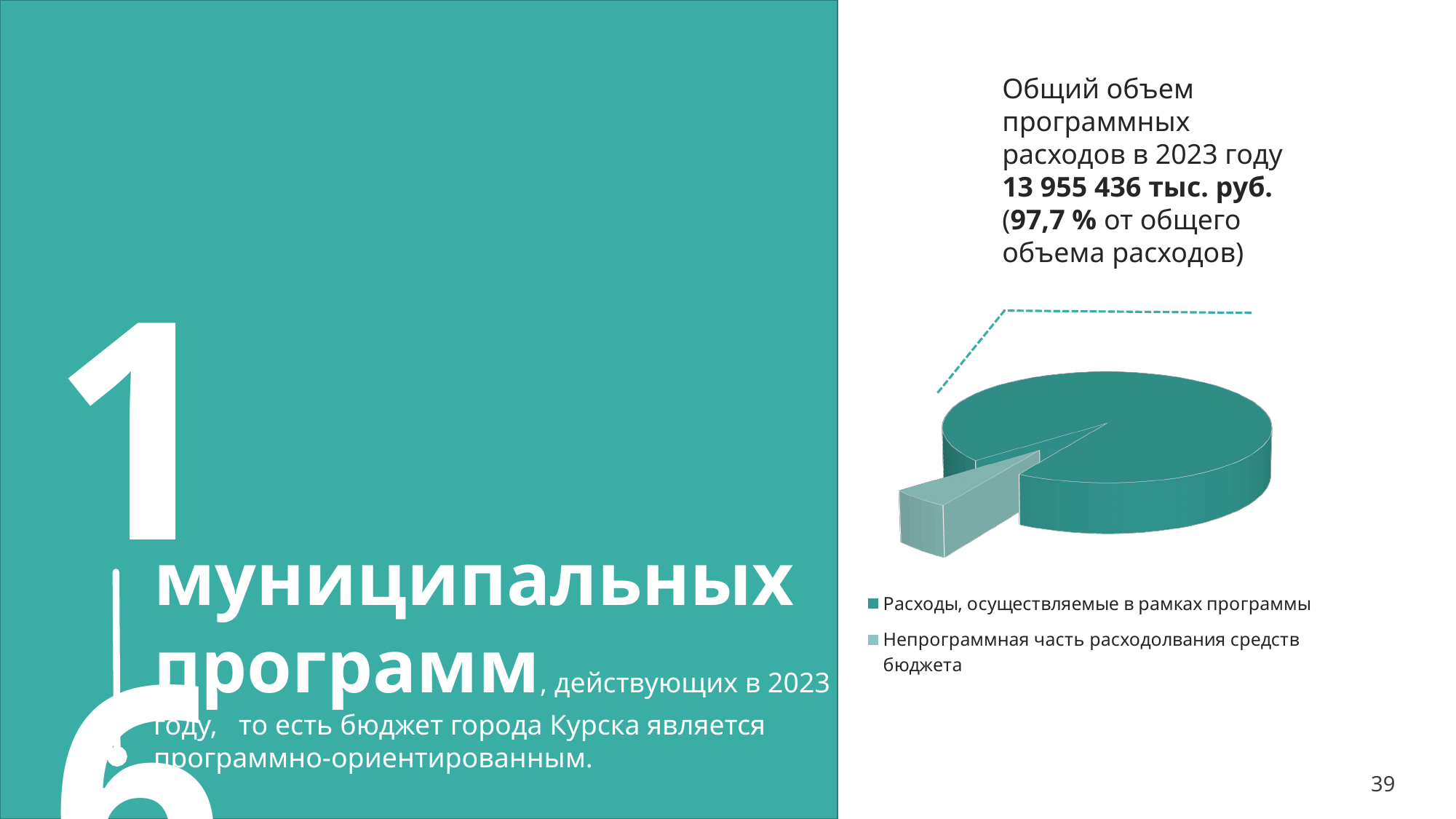
Which legend entry is shown in the lighter grey-green colour? Непрограммная часть расходолвания средств бюджета Which slice of the pie chart is the largest? Расходы, осуществляемые в рамках программы How many entries does the legend of the pie chart list? 2 Is the share of program expenses greater or less than 50%? greater What is the total volume of program expenses in 2023 stated on the slide? 13 955 436 тыс. руб. What kind of chart is shown on the slide? Pie chart Which is larger: the slice for program expenses or the slice for the non-program part of budget spending? Расходы, осуществляемые в рамках программы Which slice of the pie chart is pulled out (exploded) from the rest of the pie? Непрограммная часть расходолвания средств бюджета How many slices does the pie chart have? 2 What share of total expenses do the program expenses (Расходы, осуществляемые в рамках программы) represent according to the slide? 97,7 % Which slice of the pie chart is the smallest? Непрограммная часть расходолвания средств бюджета